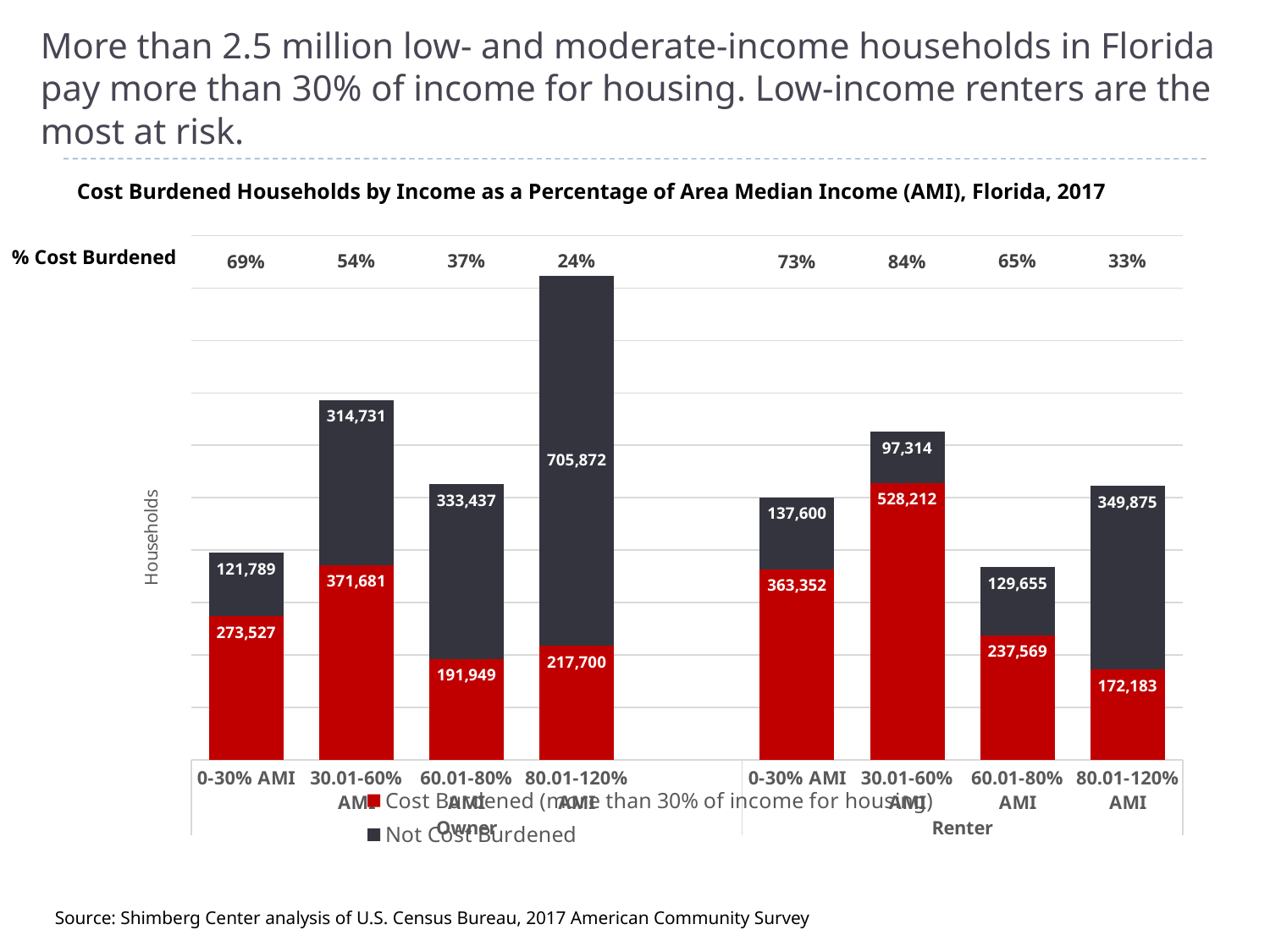
What is the % cost burdened shown for renters at 0-30% AMI? 73% Which category has the lowest % cost burdened shown above the bars? Owner 80.01-120% AMI How many series does the legend list? 2 What kind of chart is shown on the slide? Stacked bar chart Which bar has the largest number of cost burdened households? Renter 30.01-60% AMI How many cost burdened households are there among renters at 30.01-60% AMI? 528,212 How many cost burdened households are there among owners at 0-30% AMI? 273,527 How many bars are plotted in the chart? 8 Which is larger: the number of cost burdened owners at 60.01-80% AMI or the number of cost burdened renters at 60.01-80% AMI? Renters at 60.01-80% AMI How many not cost burdened households are there among owners at 80.01-120% AMI? 705,872 What is the total number of households in the Owner 80.01-120% AMI bar? 923,572 What is the difference between cost burdened and not cost burdened households for renters at 0-30% AMI? 225,752